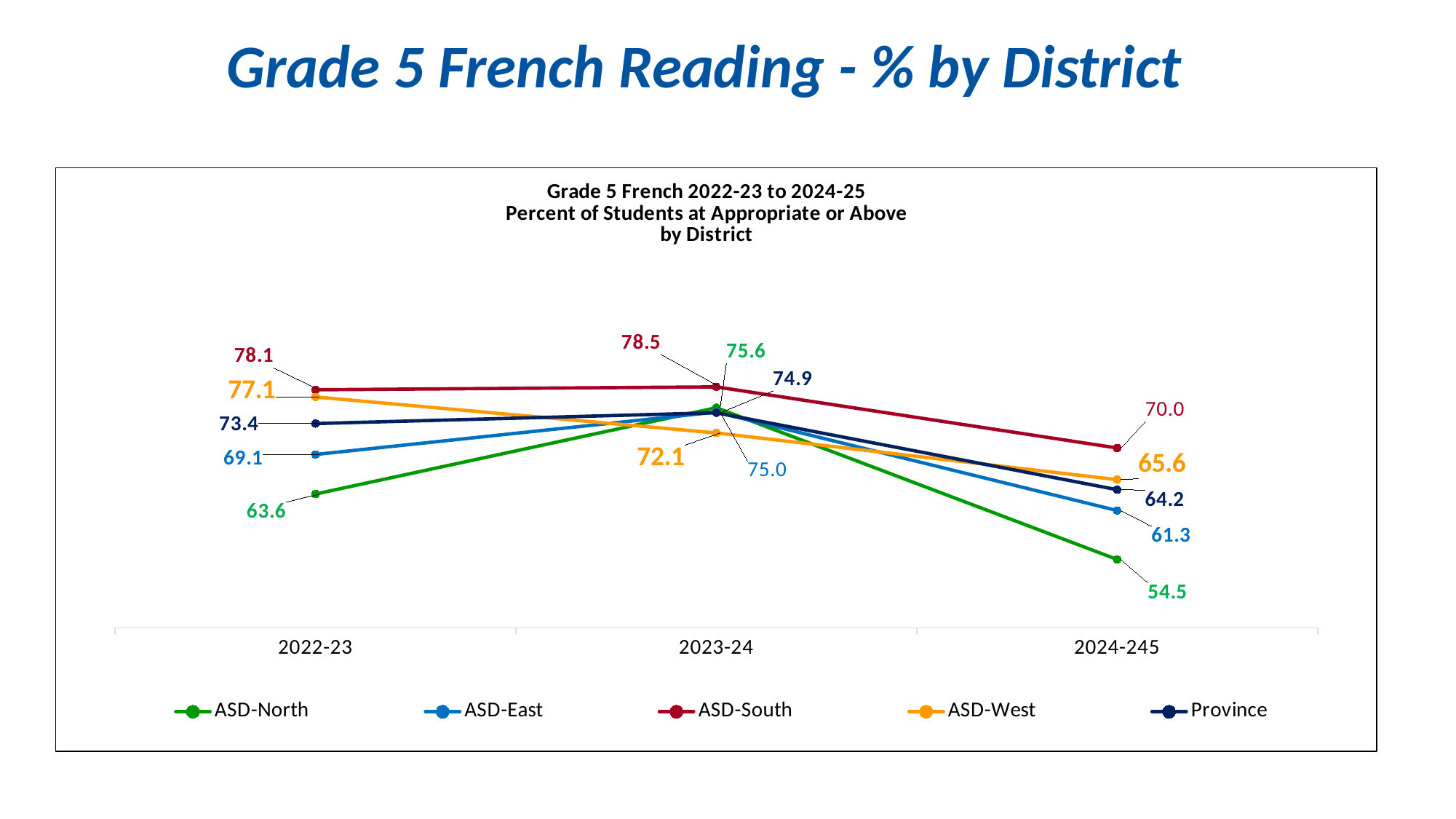
Does the ASD-North line rise or fall from 2023-24 to 2024-245? fall How many series does the legend list? 5 Which district has the highest value in 2024-245? ASD-South Which series has the lowest value in 2022-23? ASD-North By how much did ASD-South's value fall from 2023-24 to 2024-245? 8.5 How many school years are shown on the x axis? 3 What is the value for ASD-North in 2024-245? 54.5 In 2022-23, which is larger: ASD-West or ASD-East? ASD-West By how much did ASD-North's value rise from 2022-23 to 2023-24? 12.0 What is the value for ASD-South in 2022-23? 78.1 What kind of chart is shown on the slide? line chart What is the value for ASD-West in 2023-24? 72.1